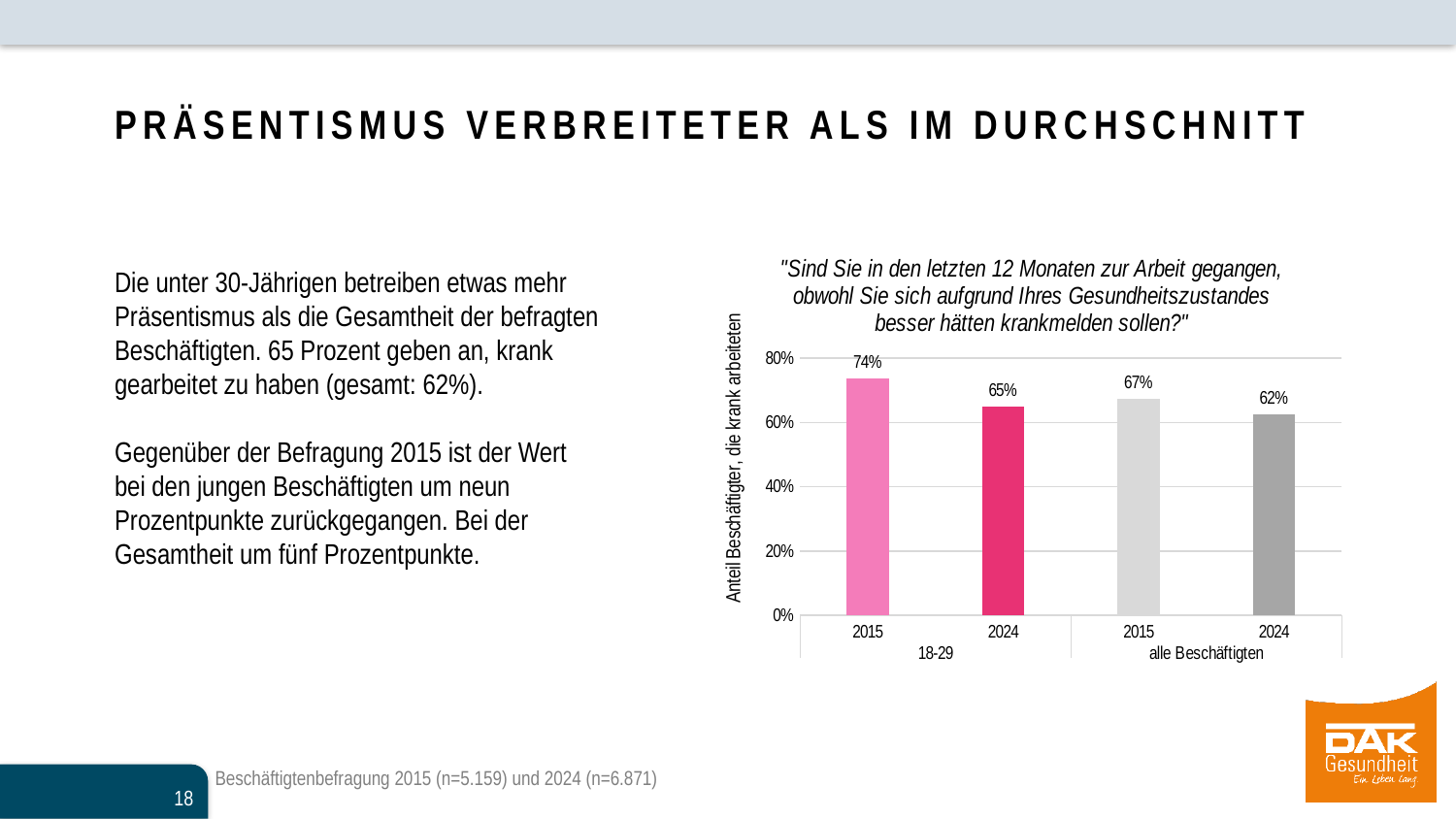
What is the value for 2024 for alle Beschäftigten? 62% What is the value for 2015 in the 18-29 group? 74% What is the label of the vertical axis? Anteil Beschäftigter, die krank arbeiteten What kind of chart is shown on the slide? Bar chart Which bar has the highest value? 2015, 18-29 What is the value for 2024 in the 18-29 group? 65% Which is larger: the 2024 value for 18-29 or the 2024 value for alle Beschäftigten? 2024 value for 18-29 What is the difference between the 2015 and 2024 values for the 18-29 group? 9 percentage points What is the value for 2015 for alle Beschäftigten? 67% Which bar has the lowest value? 2024, alle Beschäftigten How many bars are shown in the chart? 4 What is the difference between the 2015 and 2024 values for alle Beschäftigten? 5 percentage points